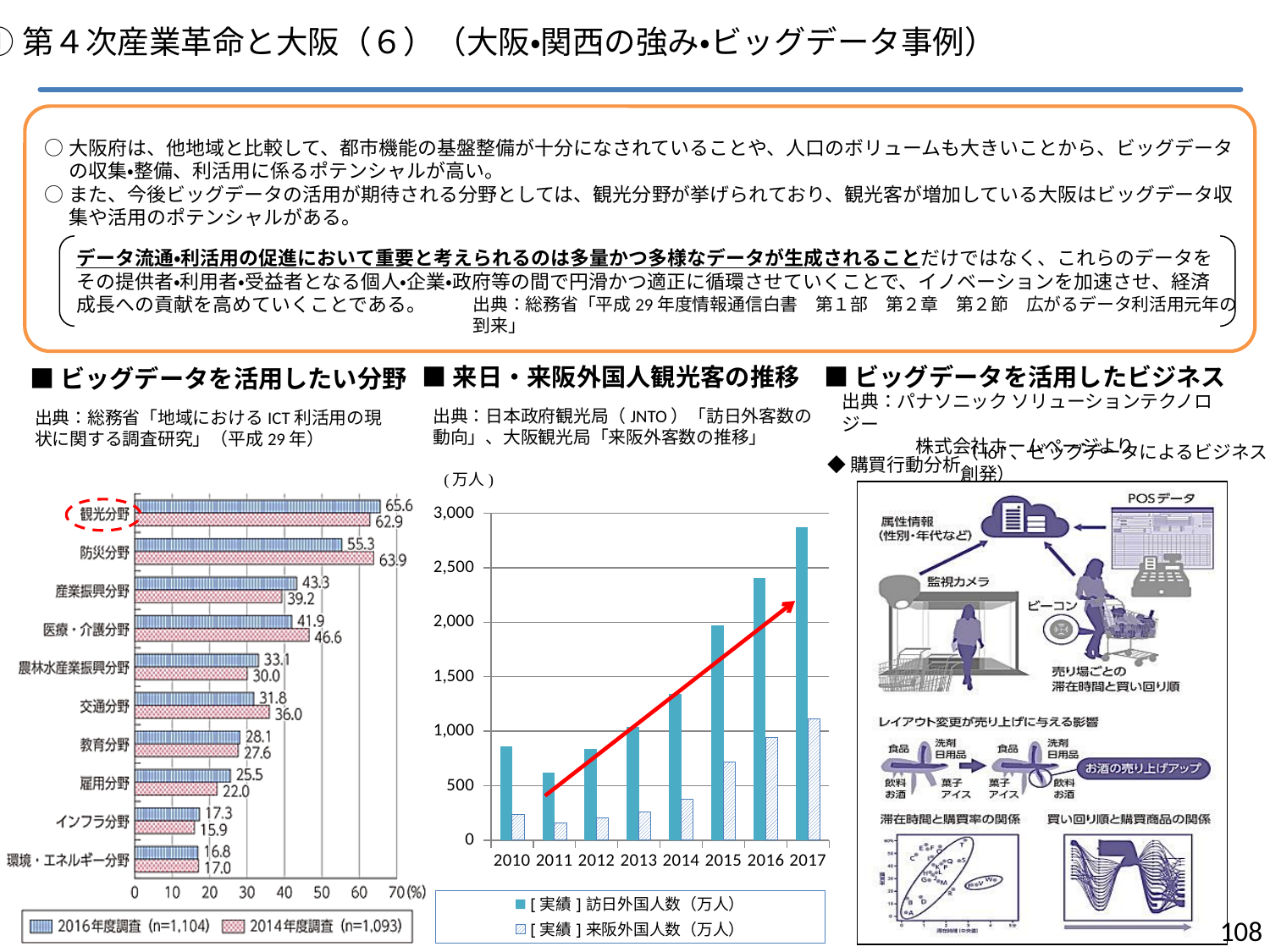
In the chart titled ビッグデータを活用したい分野, how many categories are shown? 10 In the chart titled ビッグデータを活用したい分野, what is the 2014年度調査 value for 防災分野? 63.9 In the chart titled ビッグデータを活用したい分野, what is the 2016年度調査 value for 観光分野? 65.6 What kind of chart is the chart titled 来日・来阪外国人観光客の推移? bar chart In the chart titled ビッグデータを活用したい分野, which category has the lowest 2014年度調査 value? インフラ分野 In the chart titled ビッグデータを活用したい分野, how many series does the legend list? 2 In the chart titled ビッグデータを活用したい分野, what is the difference between the 2016年度調査 and 2014年度調査 values for 防災分野? 8.6 In the chart titled 来日・来阪外国人観光客の推移, do the 訪日外国人数 values generally rise or fall from 2011 to 2017? rise In the chart titled 来日・来阪外国人観光客の推移, is the 訪日外国人数 value for 2017 greater or less than 2,500? greater In the chart titled 来日・来阪外国人観光客の推移, is the 来阪外国人数 value for 2017 greater or less than 1,000? greater In the chart titled ビッグデータを活用したい分野, which is larger for 医療・介護分野: the 2016年度調査 value or the 2014年度調査 value? 2014年度調査 In the chart titled ビッグデータを活用したい分野, which category has the highest 2016年度調査 value? 観光分野